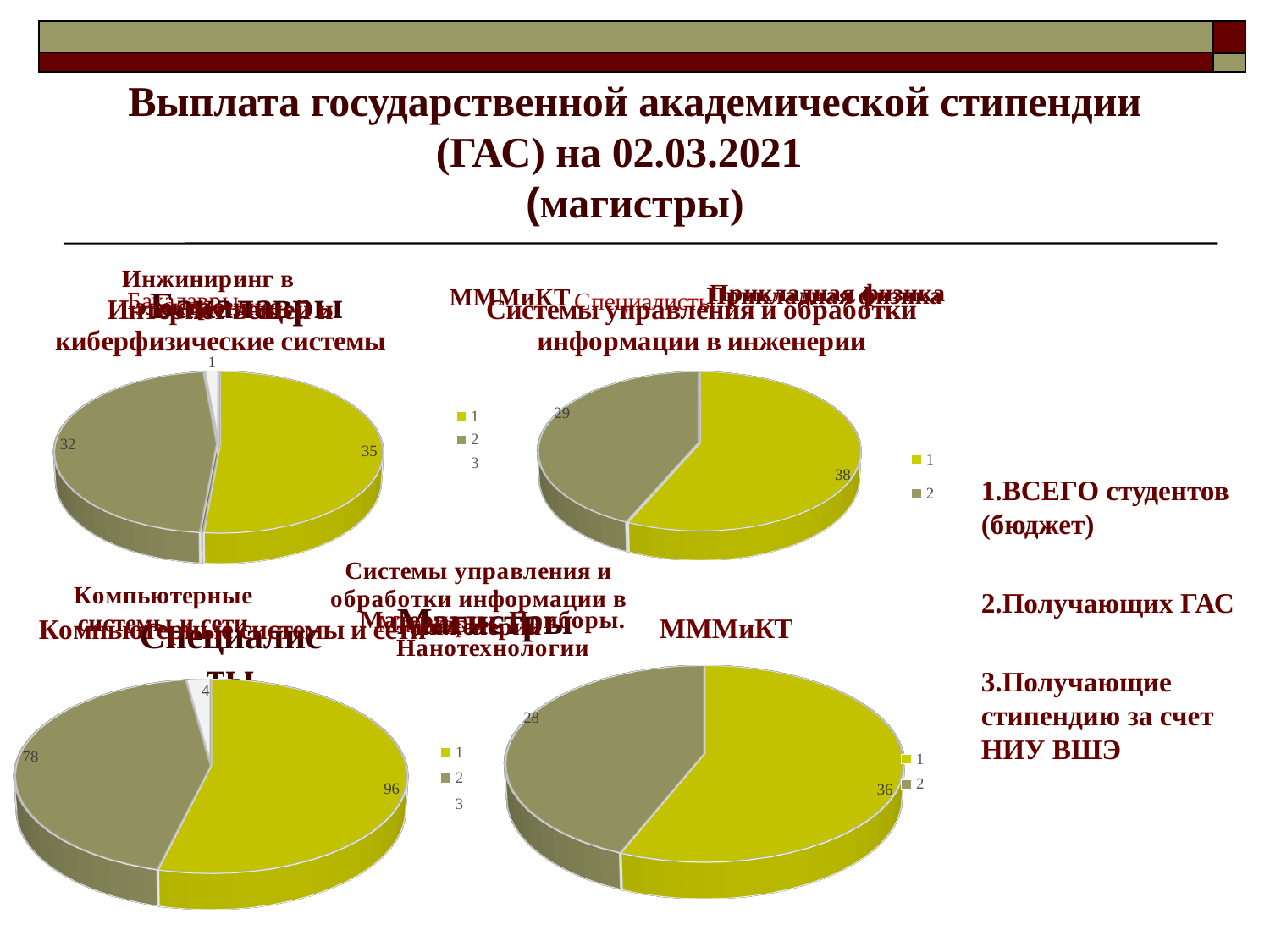
In the top-left pie chart, what is the difference between the slices labelled 35 and 32? 3 In the bottom-right pie chart titled МММиКТ, which slice is larger, the one labelled 36 or the one labelled 28? 36 In the bottom-right pie chart titled МММиКТ, what is the total of the two slices? 64 How many entries does the legend of the top-right pie chart list? 2 In the top-left pie chart, what is the value of the smallest slice? 1 In the top-right pie chart, what is the value of the larger slice? 38 What type of charts are shown on the slide? Pie charts In the top-right pie chart, what is the total of the two slices? 67 In the top-left pie chart, what is the value of the largest slice? 35 In the bottom-left pie chart, what is the value of the largest slice? 96 In the bottom-left pie chart, what is the difference between the slices labelled 96 and 78? 18 How many slices does the top-left pie chart have? 3